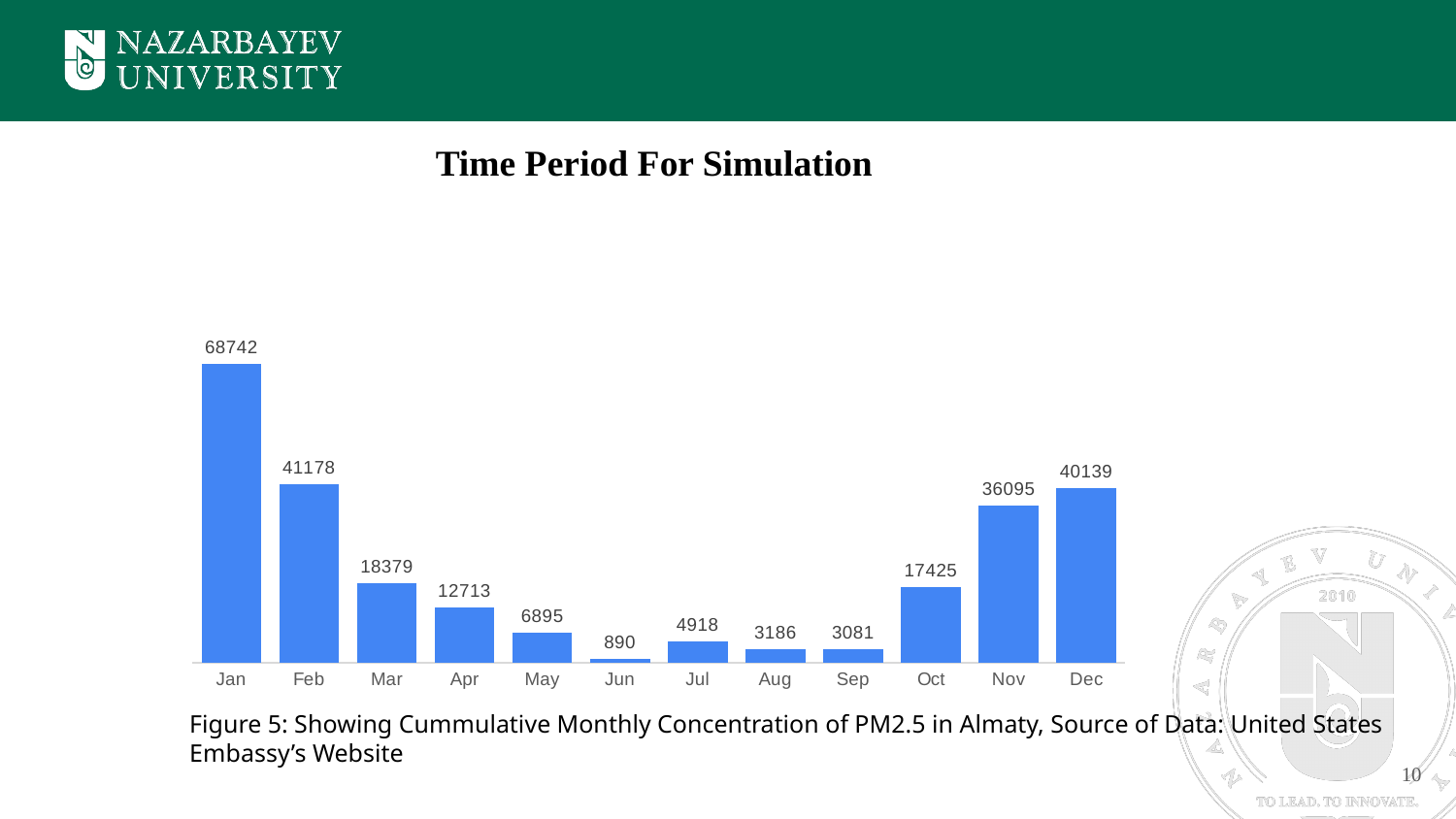
Which is larger, the value for Aug or the value for Sep? Aug Which is larger, the value for Mar or the value for Oct? Mar What is the value for Jun? 890 What is the difference between the values for Jan and Feb? 27564 How many months are shown on the x axis? 12 Which month has the lowest value? Jun What kind of chart is shown on the slide? Bar chart Do the values rise or fall from Jan to Jun? Fall What is the value for Jan? 68742 What is the difference between the values for Dec and Nov? 4044 What is the value for Nov? 36095 Which month has the highest value? Jan